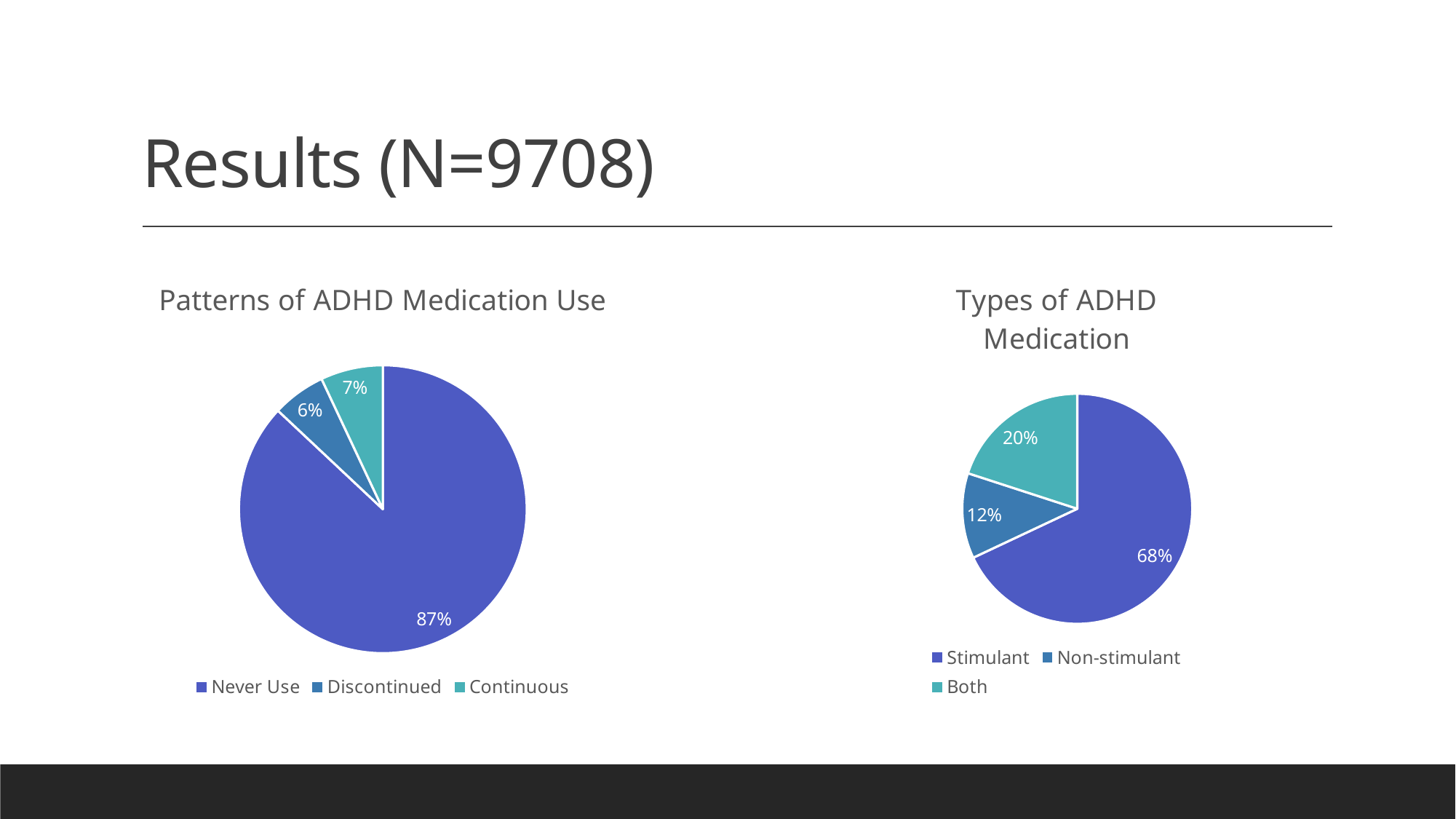
In the 'Patterns of ADHD Medication Use' chart, what percentage is shown for Continuous? 7% How many categories does the legend of the 'Types of ADHD Medication' chart list? 3 In the 'Types of ADHD Medication' chart, what percentage is shown for Both? 20% What kind of chart is the 'Patterns of ADHD Medication Use' chart? Pie chart In the 'Patterns of ADHD Medication Use' chart, what percentage is shown for Discontinued? 6% In the 'Patterns of ADHD Medication Use' chart, which category has the smallest slice? Discontinued In the 'Patterns of ADHD Medication Use' chart, what percentage is shown for Never Use? 87% In the 'Types of ADHD Medication' chart, what percentage is shown for Stimulant? 68% In the 'Types of ADHD Medication' chart, what percentage is shown for Non-stimulant? 12% In the 'Types of ADHD Medication' chart, which category has the largest slice? Stimulant In the 'Types of ADHD Medication' chart, which is larger, Non-stimulant or Both? Both In the 'Patterns of ADHD Medication Use' chart, what is the difference in percentage points between Never Use and Continuous? 80